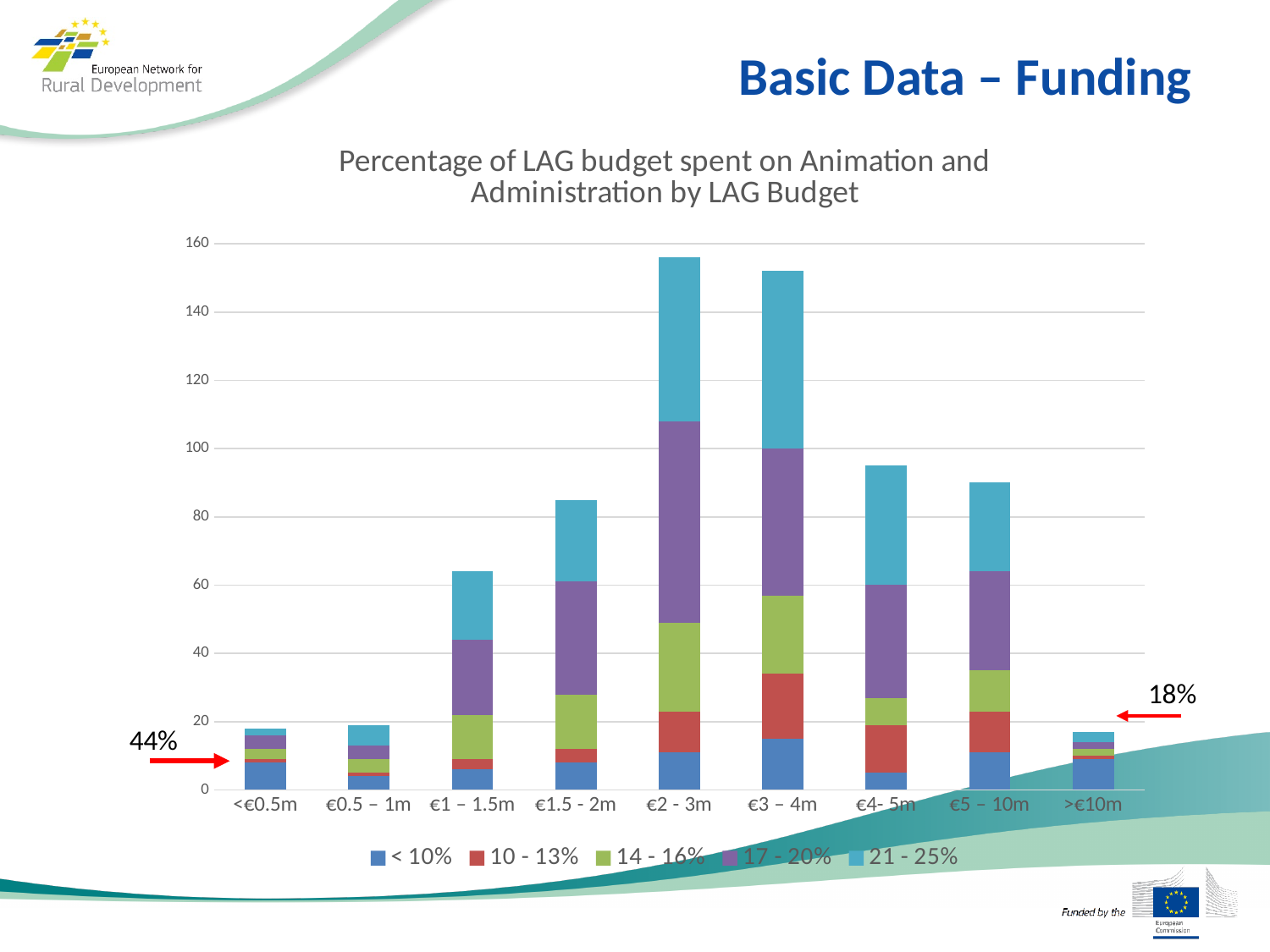
How many LAG budget categories are shown on the x axis? 9 Is the total height of the stacked bar for €1 – 1.5m greater or less than 80? less Is the total height of the stacked bar for €2 - 3m greater or less than 140? greater Is the total height of the stacked bar for €4- 5m greater or less than 80? greater What kind of chart is shown on the slide? Stacked bar chart What is the title of the chart? Percentage of LAG budget spent on Animation and Administration by LAG Budget Which stacked bar is taller in total, €2 - 3m or €1 – 1.5m? €2 - 3m Which stacked bar is taller in total, €1 – 1.5m or €1.5 - 2m? €1.5 - 2m Which series does the legend list first? < 10% How many series does the legend list? 5